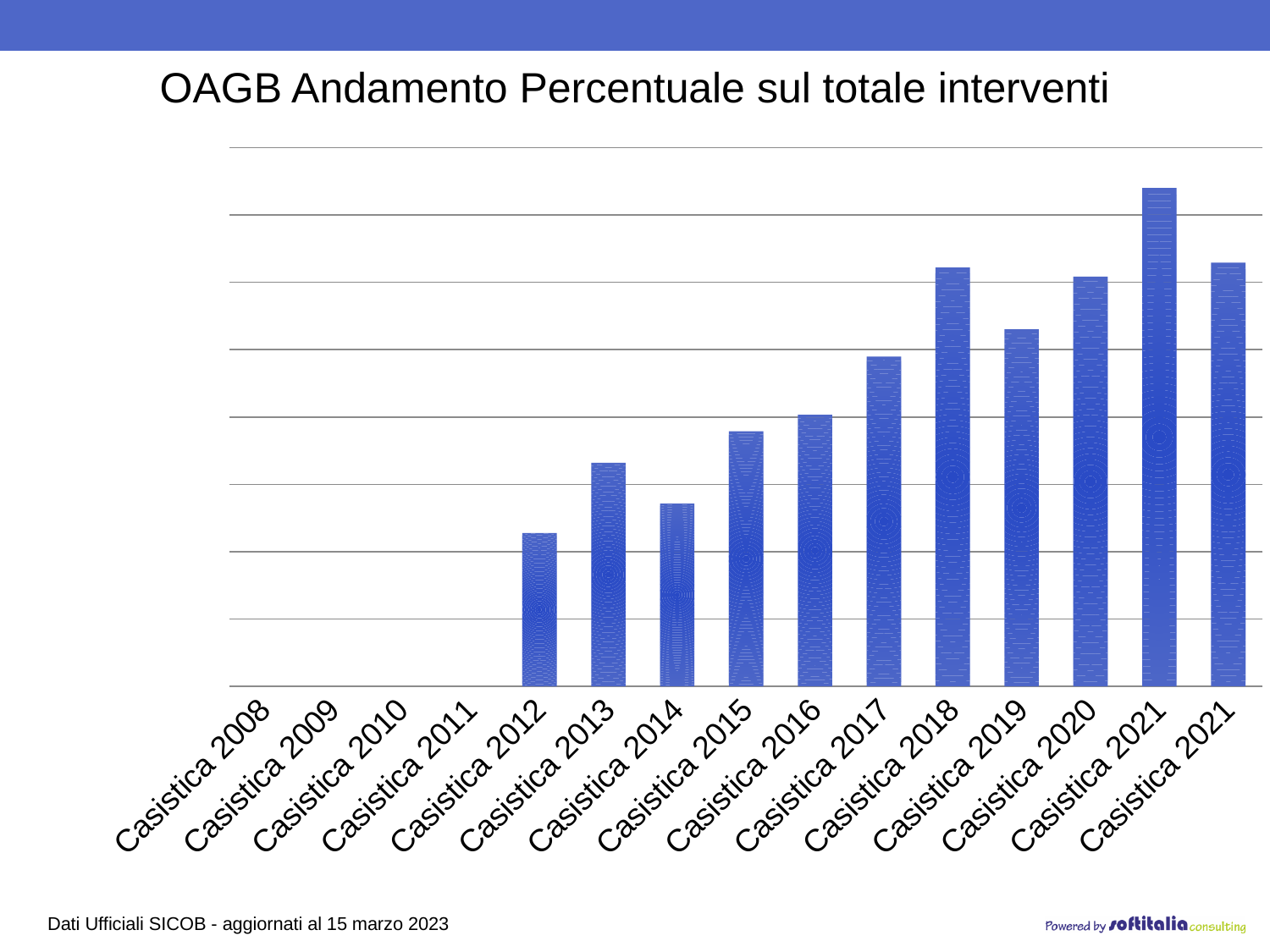
Which is larger, the bar for Casistica 2013 or the bar for Casistica 2014? Casistica 2013 How many categories on the x axis have a visible bar? 11 How many categories are shown along the x axis of the chart? 15 Among the categories with a visible bar, which has the shortest bar? Casistica 2012 Which is larger, the bar for Casistica 2018 or the bar for Casistica 2019? Casistica 2018 What is the first category on the x axis of the chart? Casistica 2008 What kind of chart is shown on the slide? Bar chart Which category has the tallest bar in the chart? Casistica 2021 (the second-to-last bar) Which is larger, the bar for Casistica 2017 or the bar for Casistica 2019? Casistica 2019 What is the title of the chart? OAGB Andamento Percentuale sul totale interventi Do the bars generally rise or fall from Casistica 2012 to the second-to-last bar (Casistica 2021)? Rise